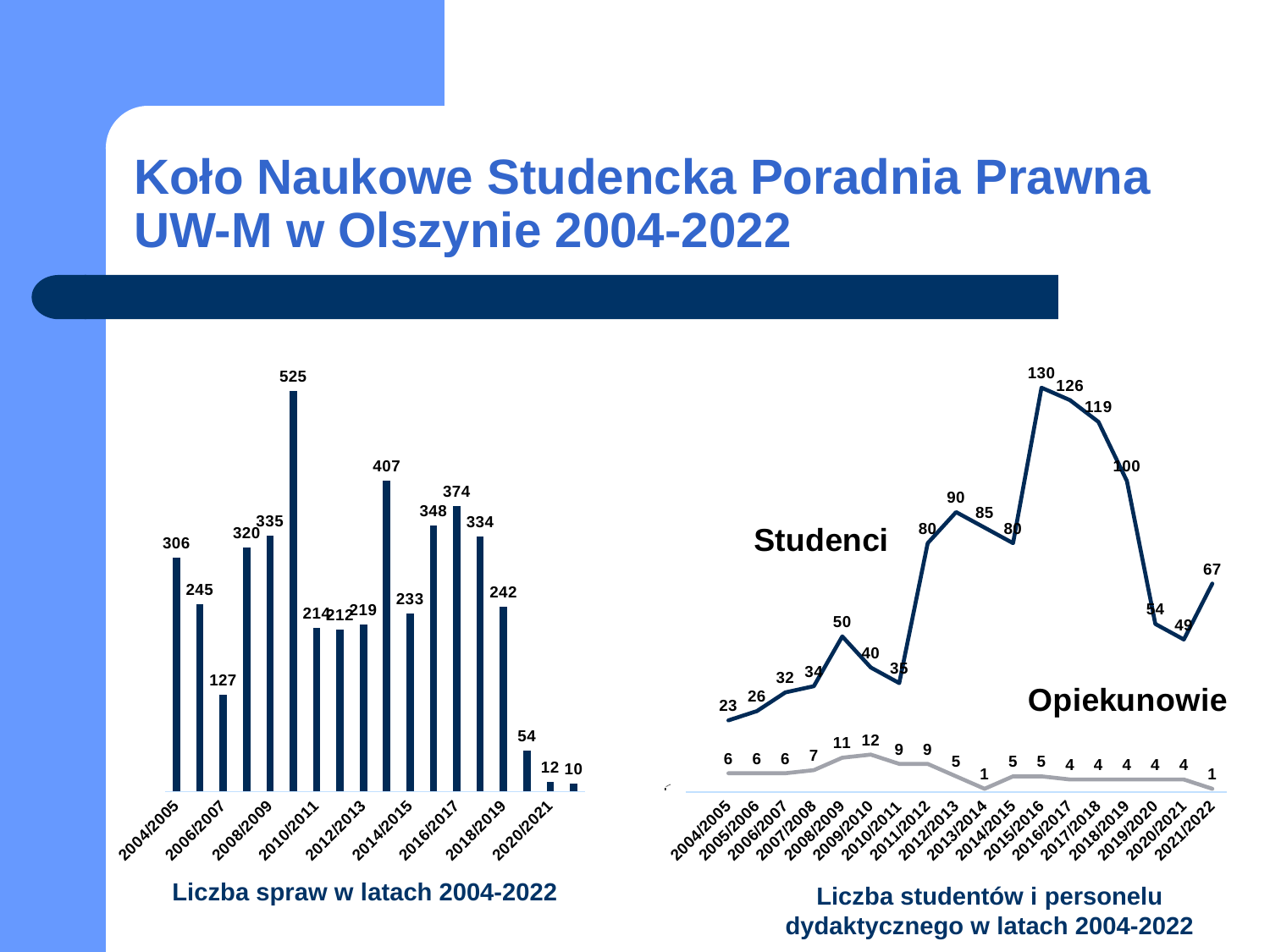
What type of chart is the left chart titled 'Liczba spraw w latach 2004-2022'? bar chart In the left chart 'Liczba spraw w latach 2004-2022', what is the lowest value shown on any bar? 10 What type of chart is the right chart titled 'Liczba studentów i personelu dydaktycznego w latach 2004-2022'? line chart In the right chart 'Liczba studentów i personelu dydaktycznego w latach 2004-2022', which year has the larger Studenci value, 2012/2013 or 2013/2014? 2012/2013 In the left chart 'Liczba spraw w latach 2004-2022', what is the value for 2004/2005? 306 In the left chart 'Liczba spraw w latach 2004-2022', what is the value for 2016/2017? 374 How many bars are plotted in the left chart 'Liczba spraw w latach 2004-2022'? 18 In the left chart 'Liczba spraw w latach 2004-2022', what is the highest value shown on any bar? 525 In the right chart 'Liczba studentów i personelu dydaktycznego w latach 2004-2022', what is the Studenci value for 2015/2016? 130 In the right chart 'Liczba studentów i personelu dydaktycznego w latach 2004-2022', in which year does the Opiekunowie series reach its highest value? 2009/2010 In the left chart 'Liczba spraw w latach 2004-2022', what is the difference between the values for 2004/2005 and 2006/2007? 179 In the left chart 'Liczba spraw w latach 2004-2022', what is the value for 2006/2007? 127